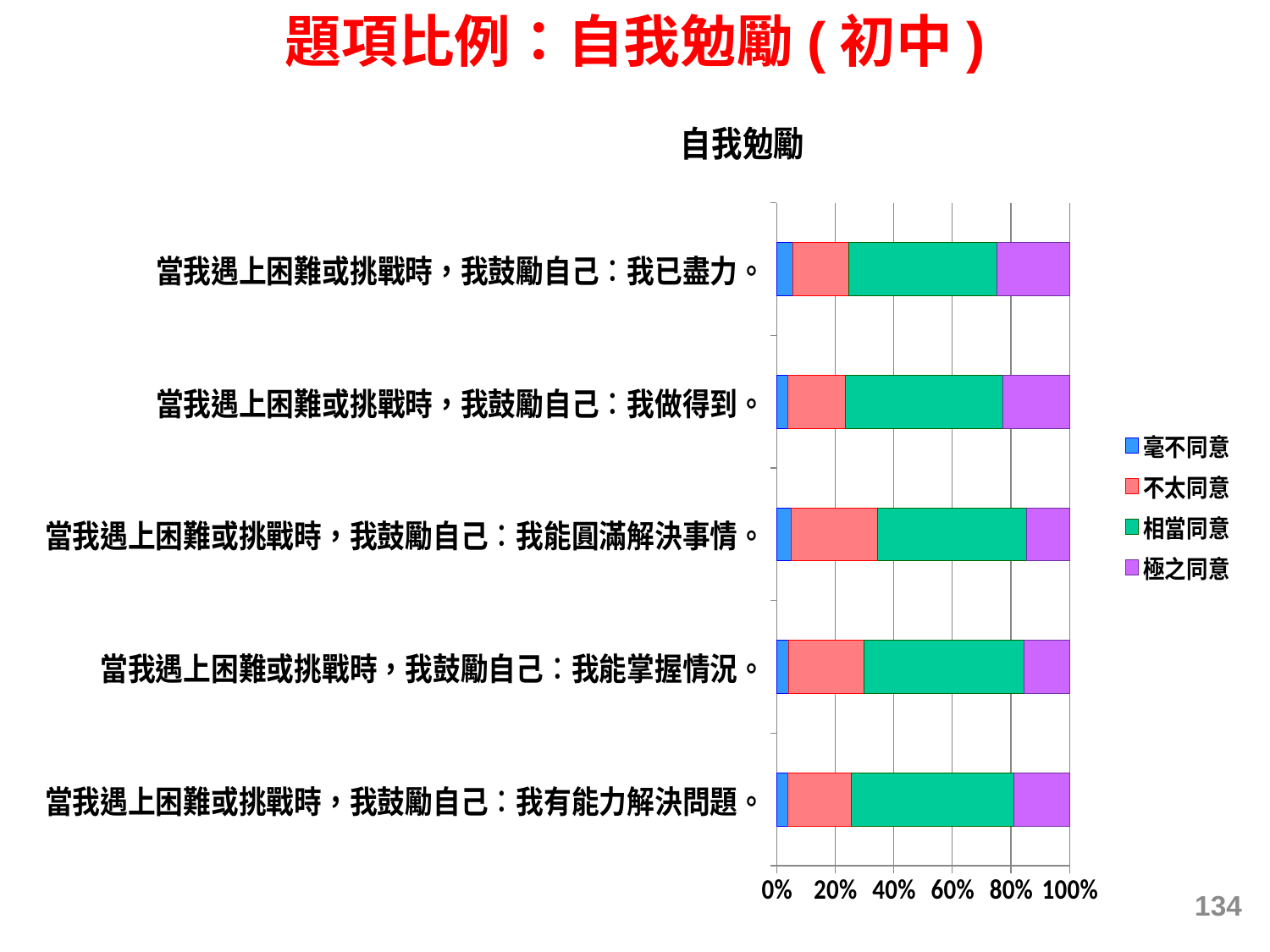
What is the title of the chart? 自我勉勵 What kind of chart is shown on the slide? Stacked bar chart Is the 不太同意 share for 「當我遇上困難或挑戰時，我鼓勵自己：我能圓滿解決事情。」 greater or less than 20%? greater How many statements (categories) are plotted in the chart? 5 What is the total of the stacked bar for 「當我遇上困難或挑戰時，我鼓勵自己：我已盡力。」? 100% Which legend entry is shown in purple? 極之同意 Is the 相當同意 share for 「當我遇上困難或挑戰時，我鼓勵自己：我已盡力。」 greater or less than 40%? greater Is the 毫不同意 share for 「當我遇上困難或挑戰時，我鼓勵自己：我有能力解決問題。」 greater or less than 20%? less How many series does the legend list? 4 Which statement has the larger 不太同意 share: 「我已盡力」 or 「我能圓滿解決事情」? 我能圓滿解決事情 Which statement has the larger 極之同意 share: 「我已盡力」 or 「我能圓滿解決事情」? 我已盡力 What is the highest value shown on the horizontal axis? 100%